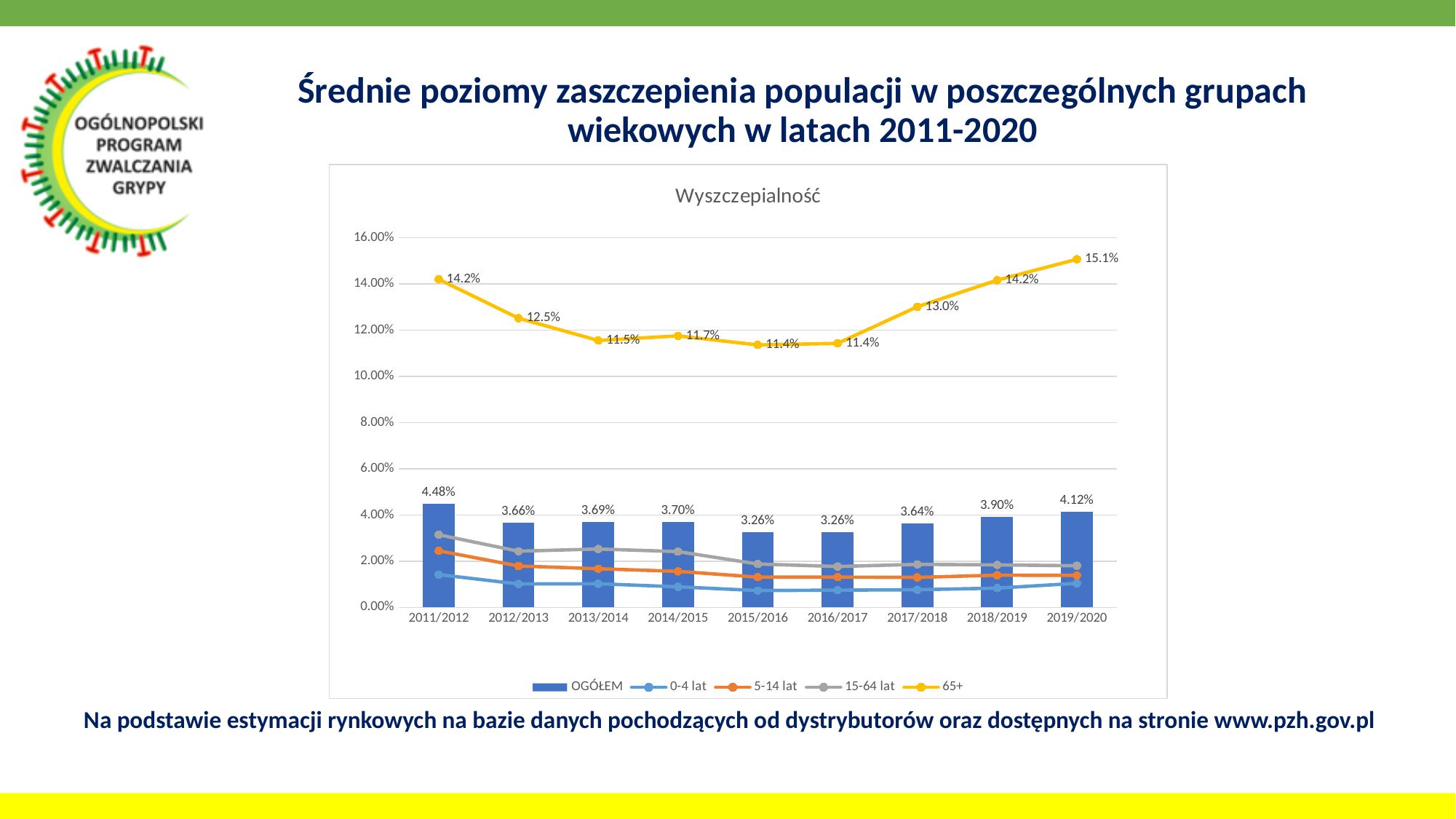
In which season is the OGÓŁEM bar highest? 2011/2012 What is the value of the 65+ series for 2019/2020? 15.1% What is the value of the 65+ series for 2013/2014? 11.5% Is the value for 0-4 lat in 2011/2012 greater or less than 2.00%? less In which season does the 65+ series reach its highest value? 2019/2020 What kind of chart is this? Combination bar and line chart How many series does the legend list? 5 Does the 65+ series rise or fall from 2016/2017 to 2019/2020? rise What is the difference between the OGÓŁEM values for 2011/2012 and 2019/2020? 0.36% What is the value of the OGÓŁEM bar for 2011/2012? 4.48% Which is larger for the 65+ series: the value for 2012/2013 or for 2017/2018? 2017/2018 How many seasons are shown on the x axis? 9